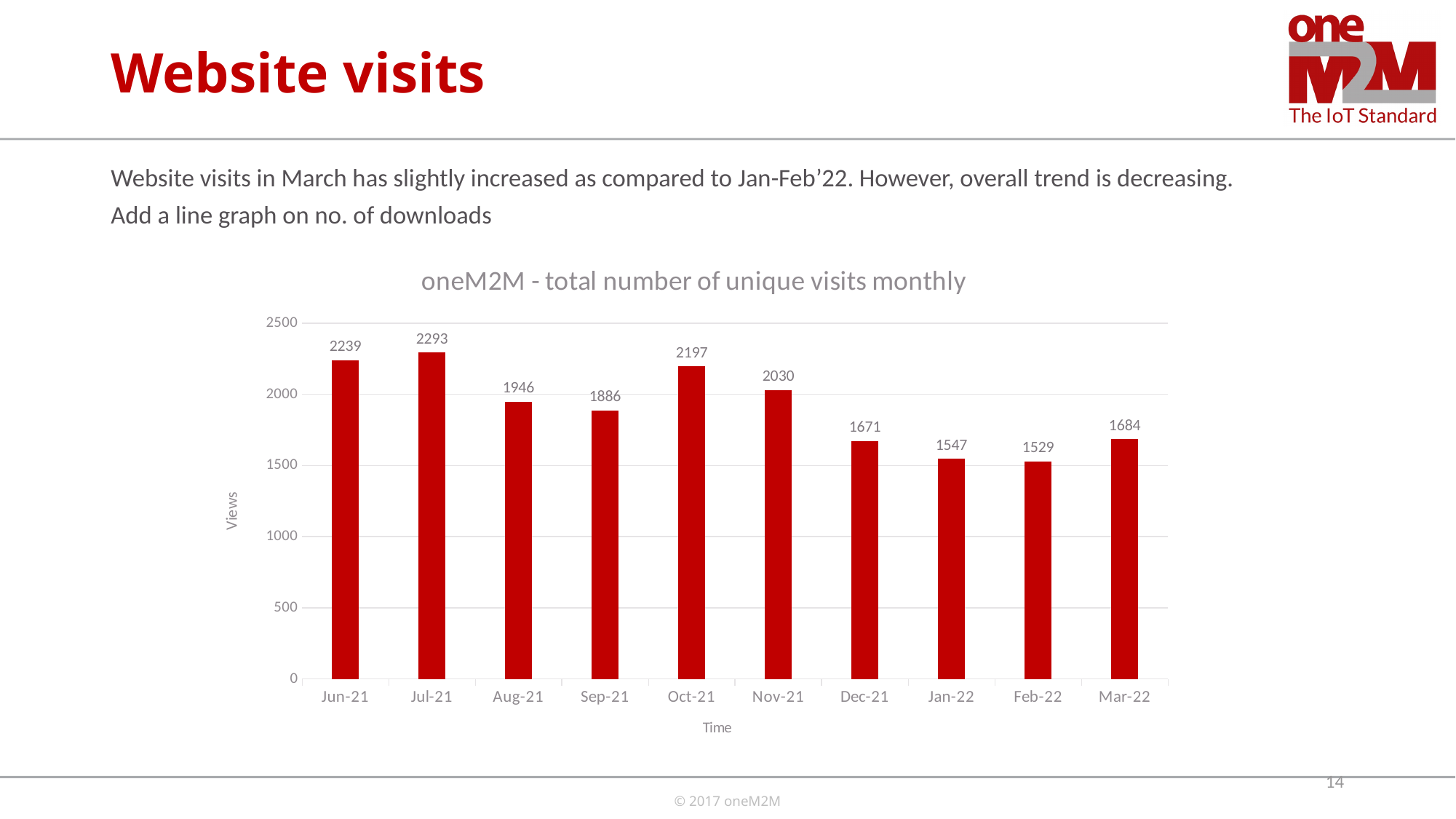
What is the difference in unique visits between Jul-21 and Feb-22? 764 What is the number of unique visits for Oct-21? 2197 What kind of chart is shown on the slide? bar chart What is the number of unique visits for Feb-22? 1529 Is the value for Dec-21 greater or less than 2000? less What is the title of the chart? oneM2M - total number of unique visits monthly Which month has the lowest number of unique visits? Feb-22 What is the number of unique visits for Mar-22? 1684 How many months are shown on the x axis of the chart? 10 What is the difference in unique visits between Mar-22 and Jan-22? 137 Which month has the highest number of unique visits? Jul-21 Which month has more unique visits, Aug-21 or Nov-21? Nov-21